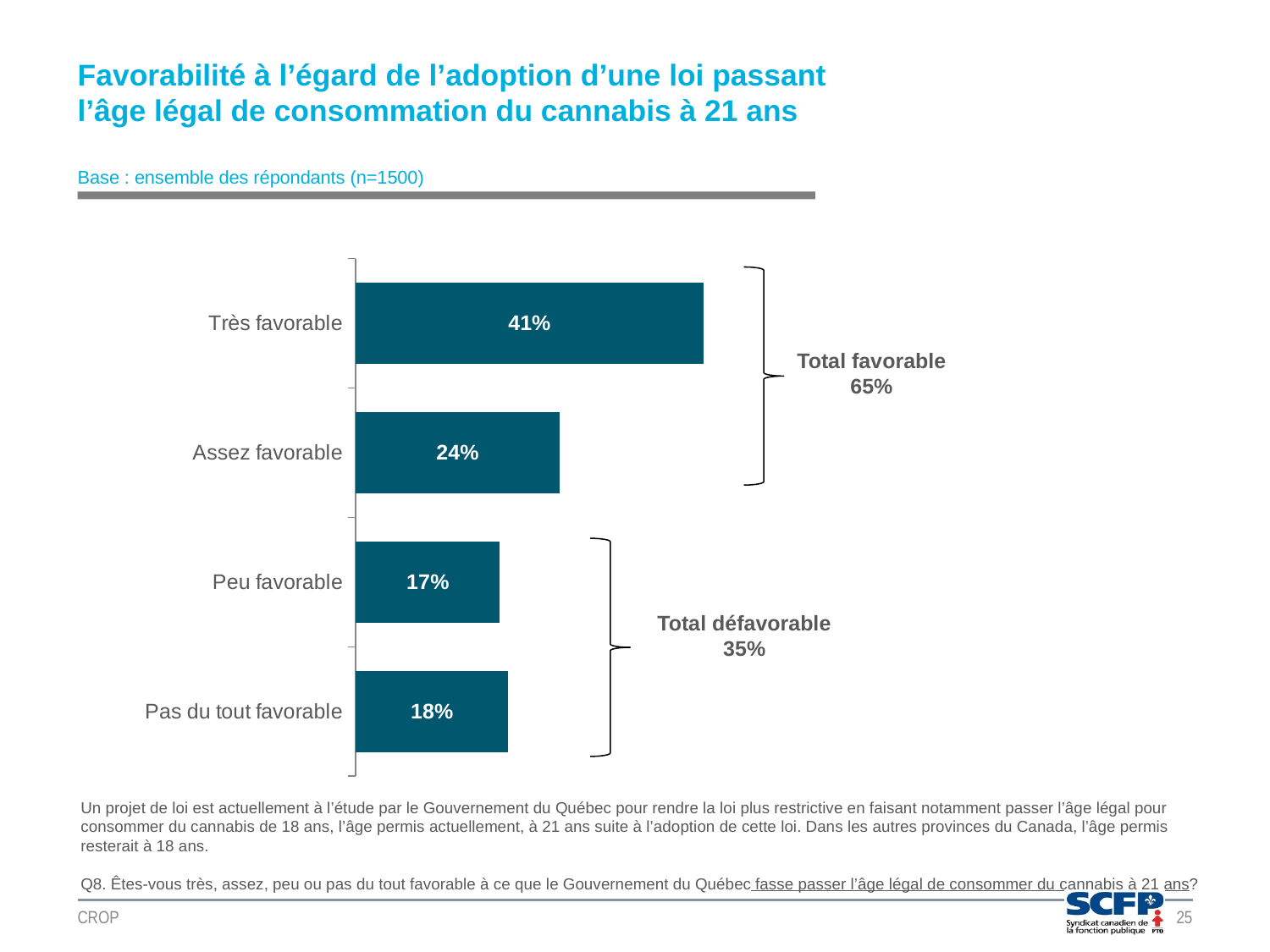
What kind of chart is shown on the slide? Bar chart Which category has the lowest value? Peu favorable What is the "Total favorable" value shown on the chart? 65% What is the value for "Très favorable"? 41% What is the value for "Pas du tout favorable"? 18% Which is larger, the value for "Pas du tout favorable" or the value for "Peu favorable"? Pas du tout favorable What is the value for "Assez favorable"? 24% Which category has the highest value? Très favorable How many categories are shown in the chart? 4 What is the value for "Peu favorable"? 17% What is the difference between the values for "Très favorable" and "Assez favorable"? 17% What is the "Total défavorable" value shown on the chart? 35%